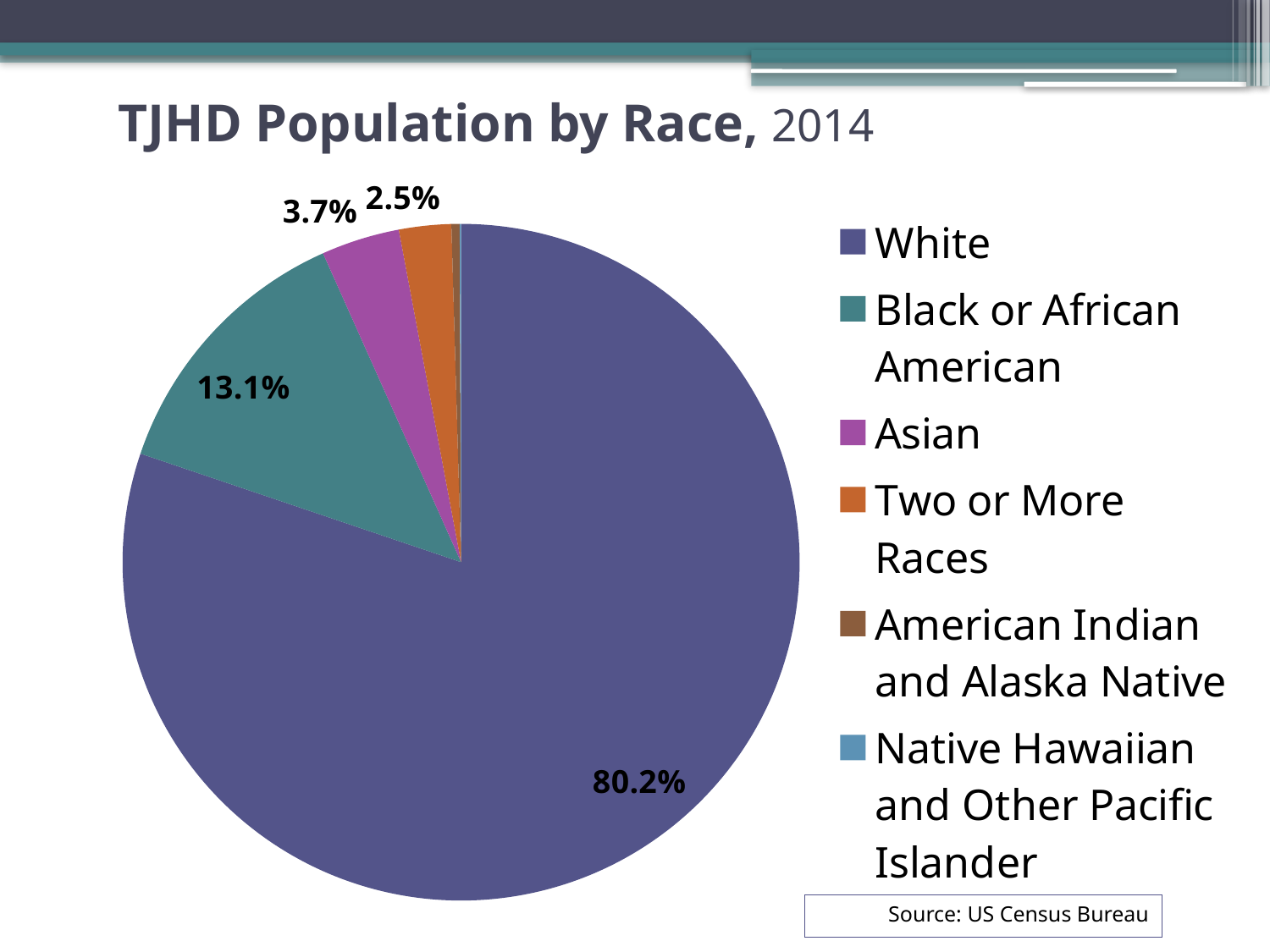
What is the difference in percentage points between the Black or African American and Asian shares? 9.4 What percentage of the TJHD population is Black or African American? 13.1% Which is larger, the Asian share or the Two or More Races share? Asian What type of chart is shown on the slide? Pie chart Which race category has the largest share of the TJHD population? White What percentage of the TJHD population is Asian? 3.7% What source is cited for the chart data? US Census Bureau What share of the pie is labelled for Two or More Races? 2.5% What is the title of the chart? TJHD Population by Race, 2014 What is the difference in percentage points between the White and Black or African American shares? 67.1 How many race categories does the legend list? 6 What percentage of the TJHD population is White? 80.2%